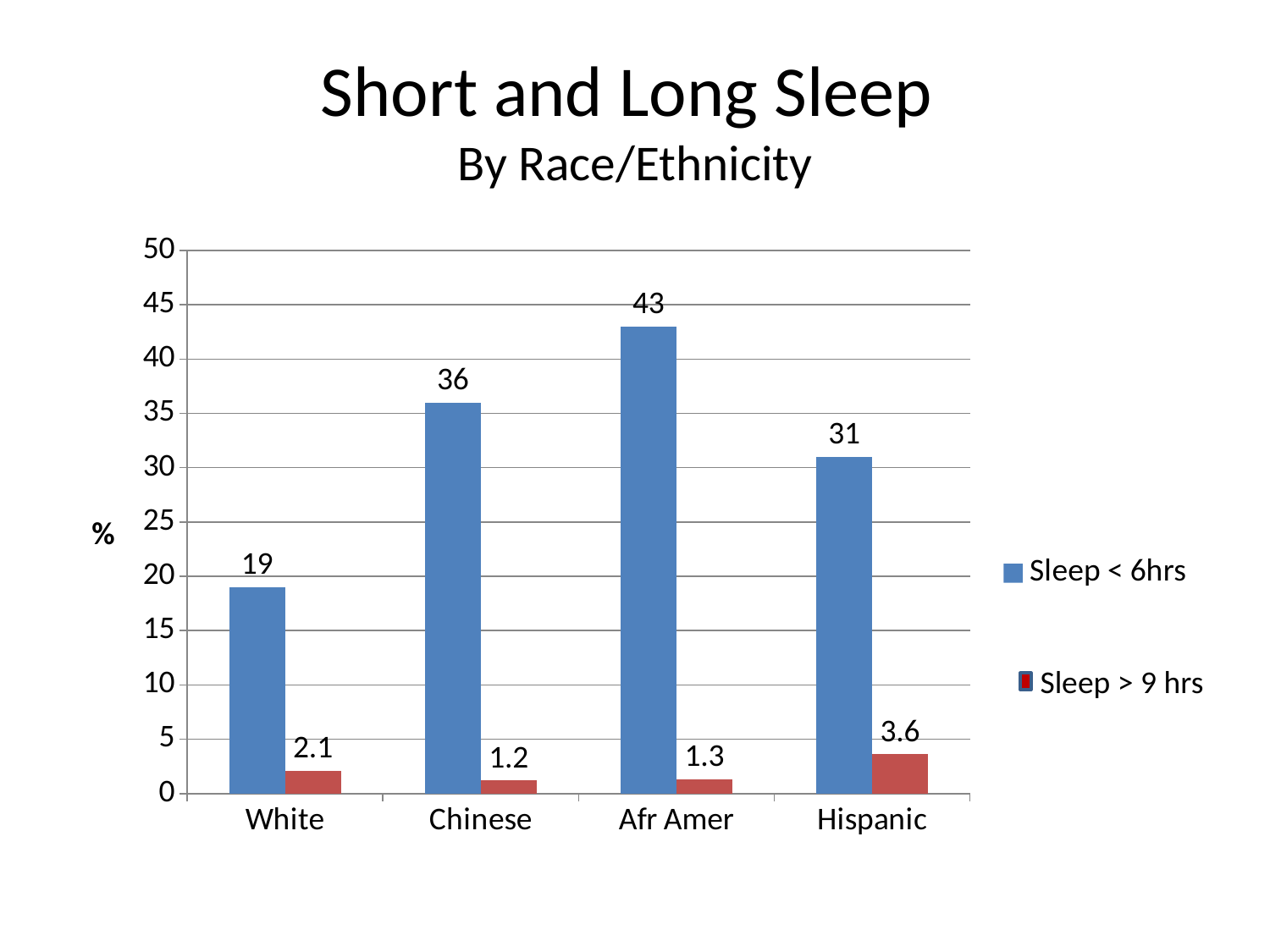
What kind of chart is shown on the slide? bar chart How many series does the legend list? 2 What is the difference between the Sleep < 6hrs values for Afr Amer and White? 24 What is the label on the vertical axis? % What is the value for Afr Amer in the Sleep < 6hrs series? 43 Which category has the lowest value in the Sleep > 9 hrs series? Chinese Which is larger in the Sleep < 6hrs series: Chinese or Hispanic? Chinese What is the value for White in the Sleep < 6hrs series? 19 How many race/ethnicity categories are shown on the x axis? 4 Which category has the highest value in the Sleep < 6hrs series? Afr Amer What is the value for Hispanic in the Sleep > 9 hrs series? 3.6 Is the Sleep < 6hrs value for Chinese greater or less than 30? greater